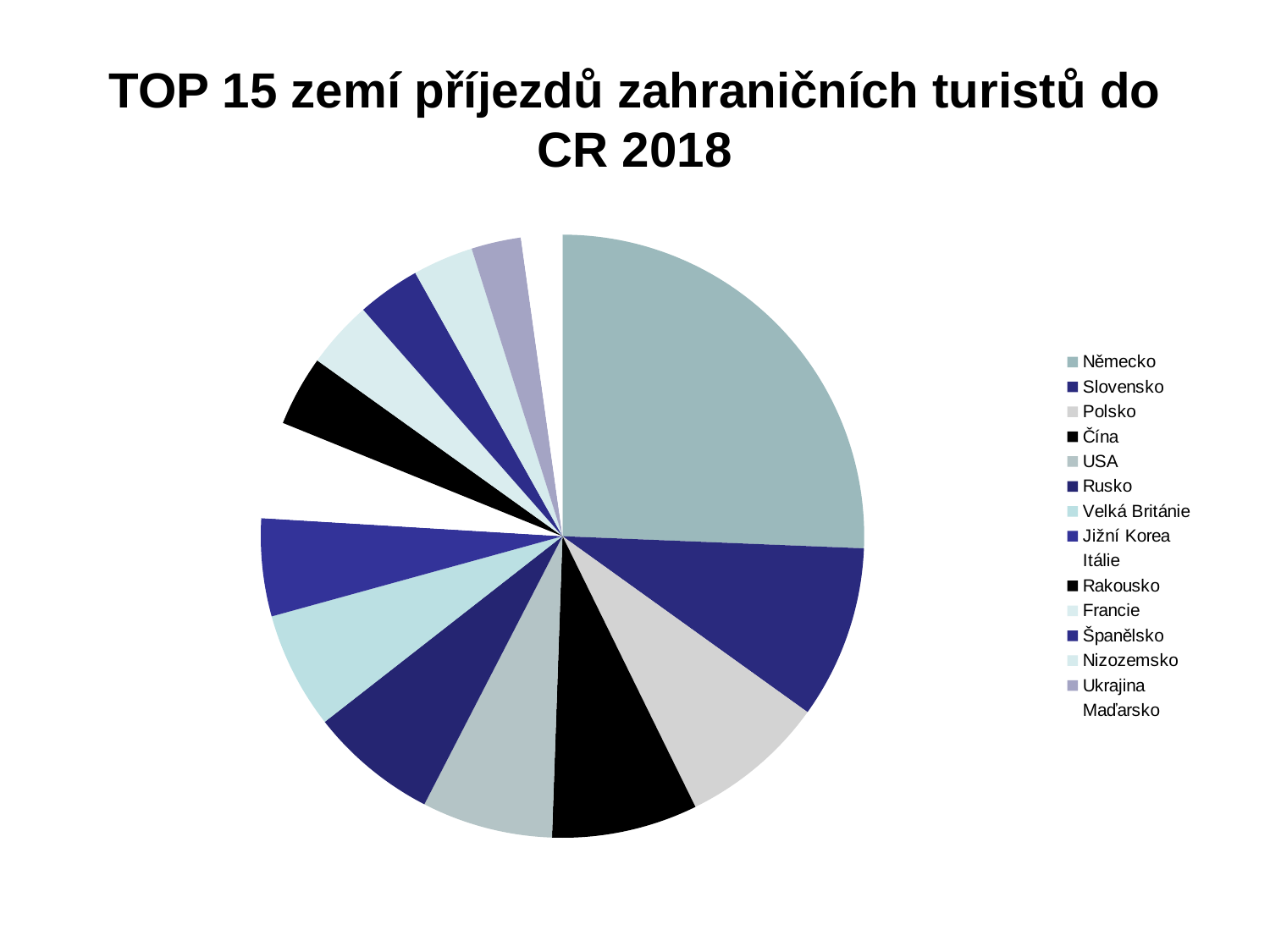
Which country has the largest slice of the pie chart? Německo Which slice is larger, Německo or Slovensko? Německo What is the title of the chart? TOP 15 zemí příjezdů zahraničních turistů do CR 2018 Which slice is larger, Polsko or Španělsko? Polsko Which country is listed first in the legend? Německo Which slice is larger, Čína or Ukrajina? Čína How many countries does the legend of the pie chart list? 15 What kind of chart is shown on the slide? pie chart